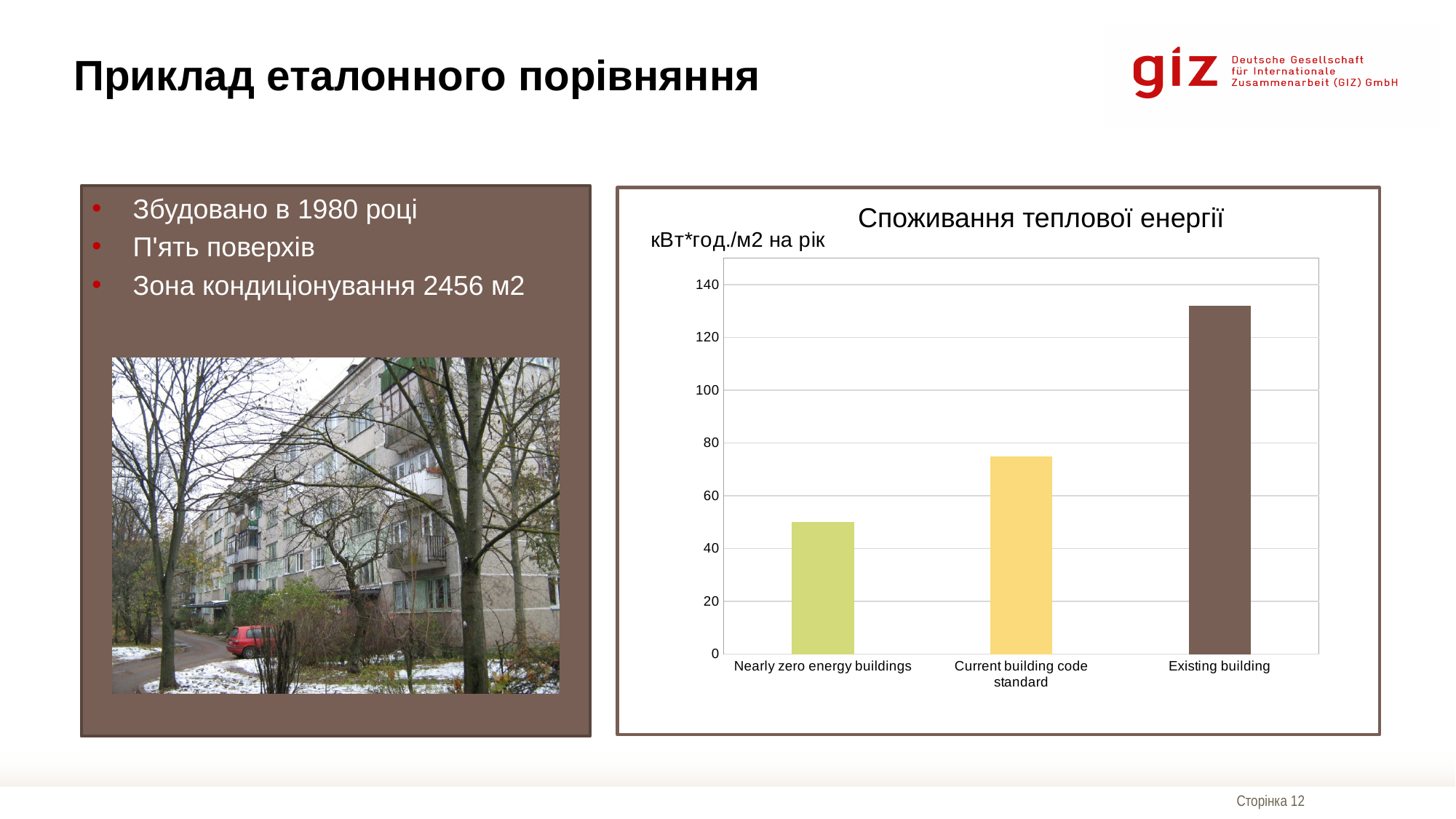
What kind of chart is shown on the slide? bar chart How many categories are plotted in the chart? 3 Which is larger, the value for Current building code standard or the value for Nearly zero energy buildings? Current building code standard What is the title of the chart? Споживання теплової енергії Which category has the lowest value in the chart? Nearly zero energy buildings Which category has the highest value in the chart? Existing building Is the value for Existing building greater or less than 120? greater Is the value for Current building code standard greater or less than 80? less Is the value for Existing building greater or less than 140? less Do the values rise or fall from left to right across the categories? rise